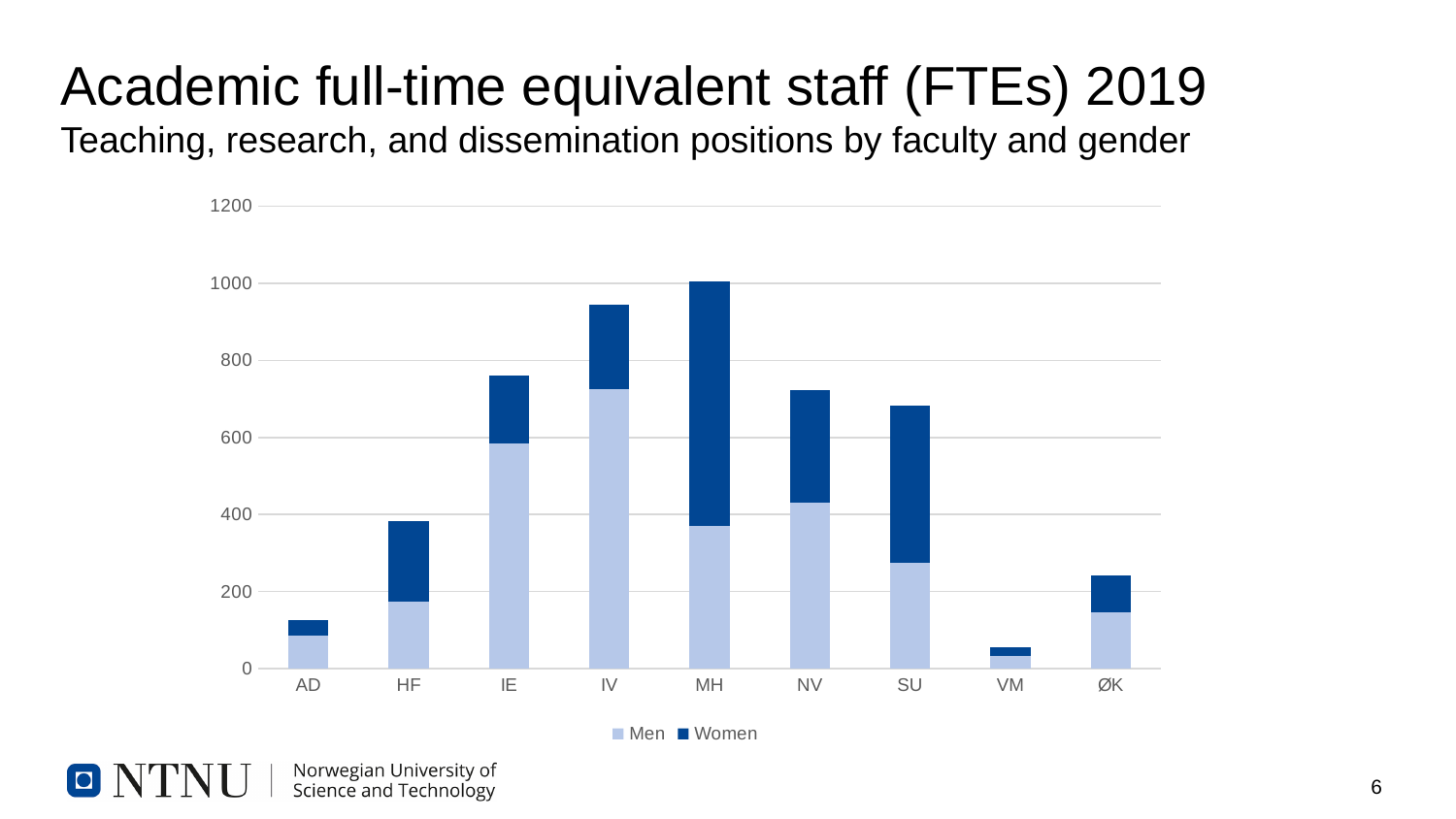
Is the total value for IV greater or less than 800? greater What kind of chart is shown on the slide? Stacked bar chart How many faculties are shown on the x axis of the chart? 9 Which is larger, the total for IV or the total for NV? IV Which faculty has the largest Men segment in the chart? IV Which series is shown in dark blue in the chart's legend? Women How many series does the chart's legend list? 2 Is the total value for IE greater or less than 800? less Is the Men value for MH greater or less than 400? less Which faculty has the lowest total academic FTEs in the chart? VM Which faculty has the highest total academic FTEs in the chart? MH